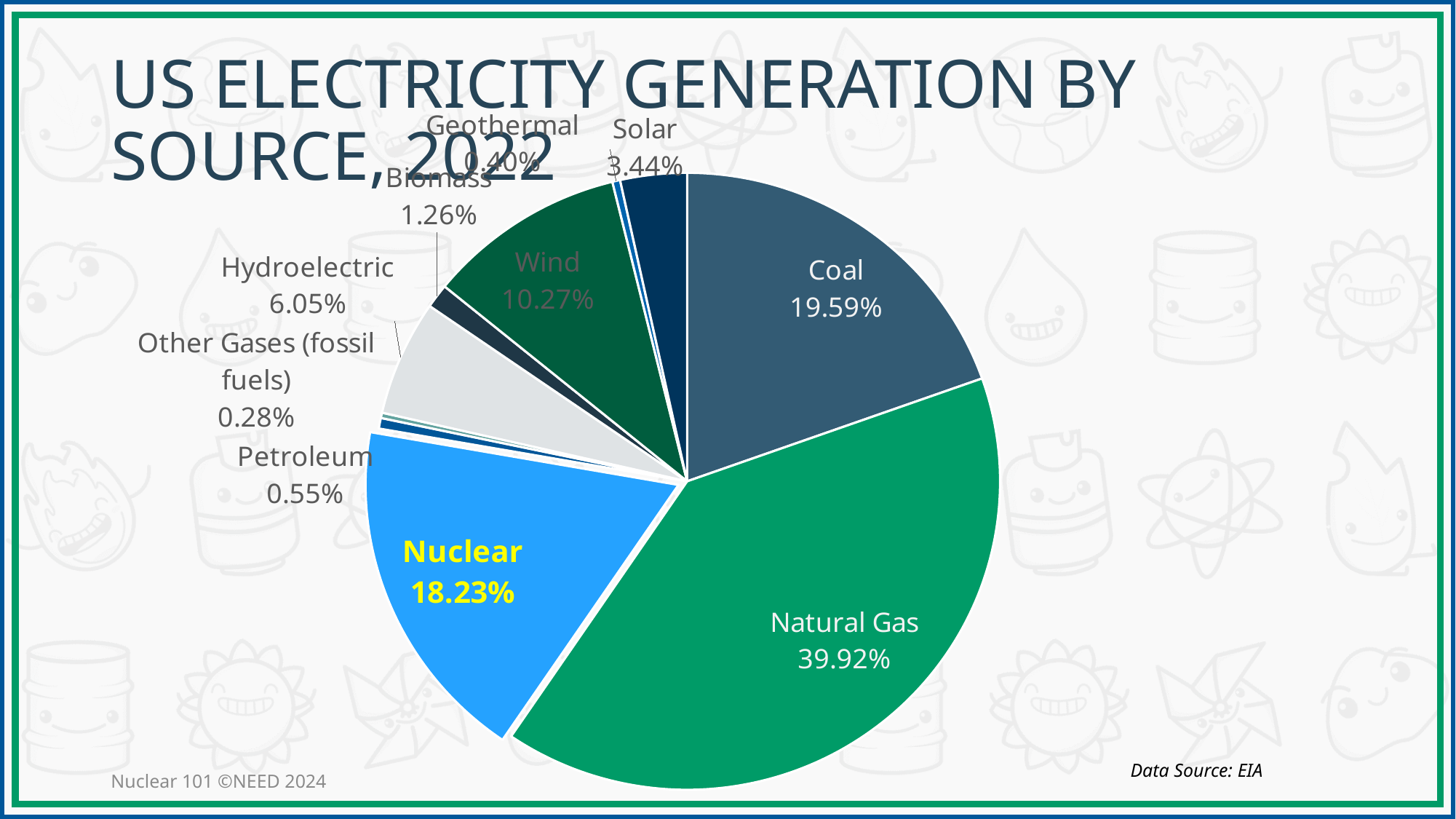
Which source has the smallest share of the pie? Other Gases (fossil fuels) Which is larger, the share for Coal or the share for Nuclear? Coal What percentage of the pie is Nuclear? 18.23% What is the value shown for Solar? 3.44% What is the value shown for Coal? 19.59% What is the difference between the Natural Gas share and the Coal share? 20.33% What share of US electricity generation in 2022 came from Natural Gas? 39.92% Which source has the largest share of the pie? Natural Gas How many sources (slices) are shown in the pie chart? 10 What share does Hydroelectric have in the pie chart? 6.05% What percentage is shown for Wind? 10.27% What type of chart is shown on the slide? Pie chart